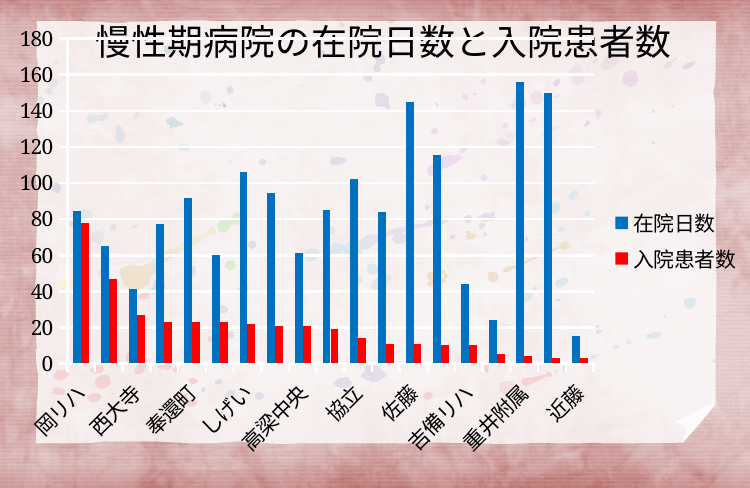
Which labelled category has the lowest 在院日数? 近藤 Which has the larger 在院日数, 佐藤 or 吉備リハ? 佐藤 Do the 入院患者数 values rise or fall from left to right along the x axis? fall Is the 在院日数 value for 吉備リハ greater or less than 60? less Is the 入院患者数 value for 岡リハ greater or less than 60? greater Which colour represents 在院日数 in the chart? blue What kind of chart is shown on the slide? bar chart What is the title of the chart? 慢性期病院の在院日数と入院患者数 How many series does the legend list? 2 Is the 在院日数 value for 西大寺 greater or less than 60? less Which category has the highest 入院患者数? 岡リハ